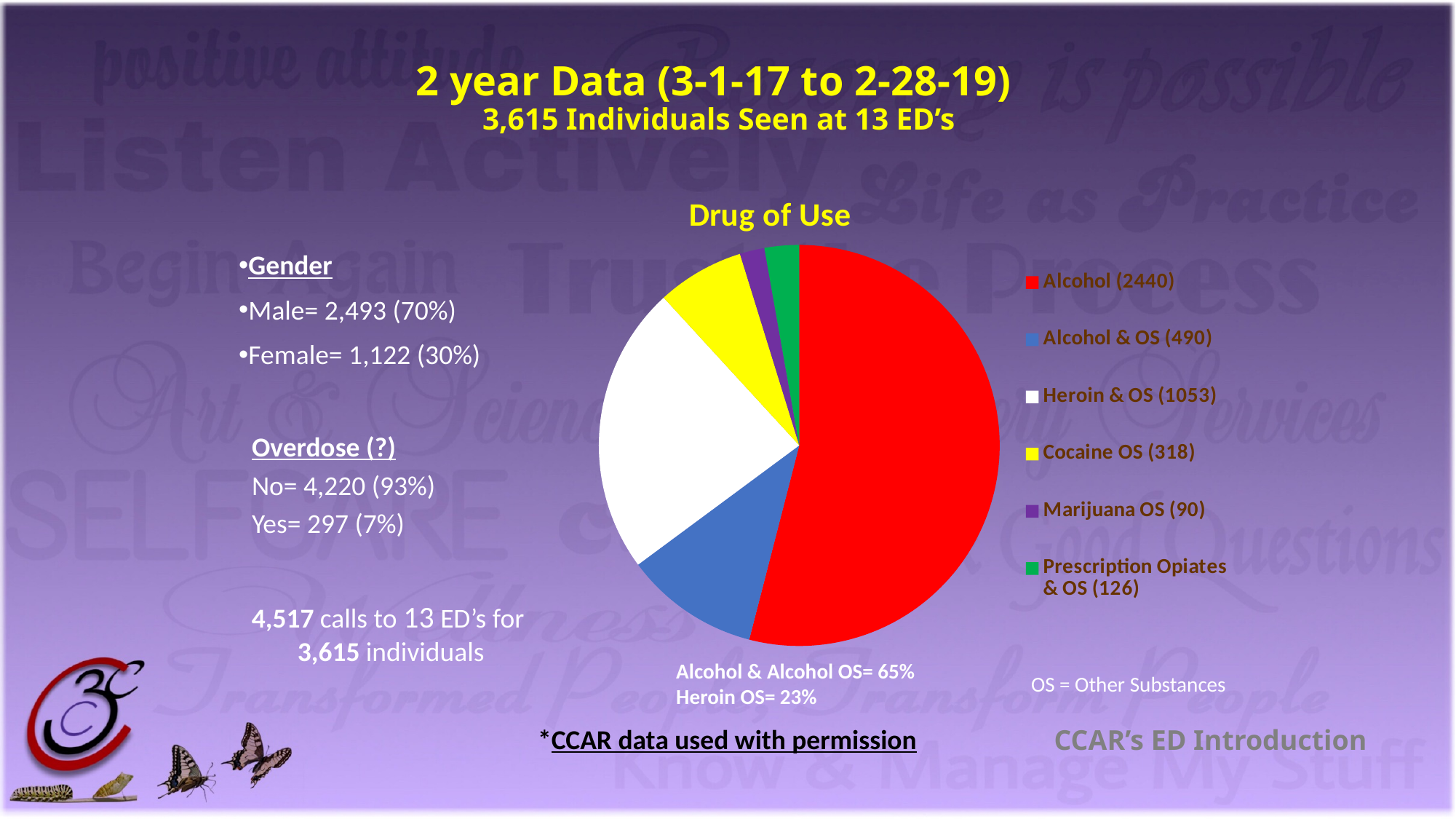
What type of chart is shown under the title "Drug of Use"? Pie chart What colour is the Cocaine OS slice in the "Drug of Use" pie chart? Yellow According to the text below the "Drug of Use" pie chart, what share do Alcohol & Alcohol OS together make up? 65% What is the value for Prescription Opiates & OS in the "Drug of Use" pie chart? 126 What is the value for Alcohol in the "Drug of Use" pie chart? 2440 What is the value for Heroin & OS in the "Drug of Use" pie chart? 1053 What is the difference between the Alcohol value and the Heroin & OS value in the "Drug of Use" pie chart? 1387 Which is larger in the "Drug of Use" pie chart: Alcohol & OS or Cocaine OS? Alcohol & OS According to the text below the "Drug of Use" pie chart, what share does Heroin OS make up? 23% Which category has the largest slice in the "Drug of Use" pie chart? Alcohol Which category has the smallest slice in the "Drug of Use" pie chart? Marijuana OS How many categories does the "Drug of Use" pie chart show? 6